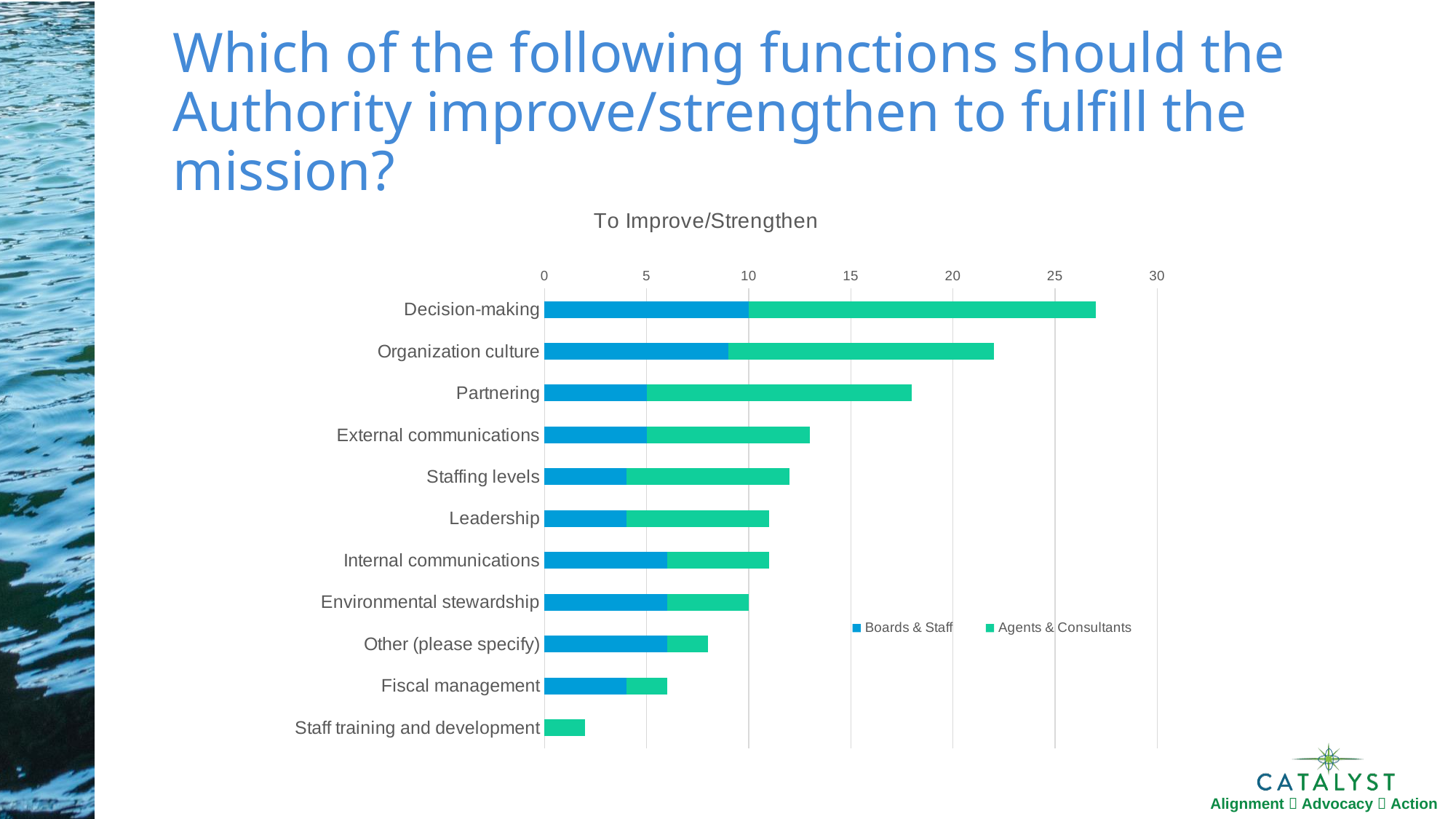
What are the two series named in the legend? Boards & Staff; Agents & Consultants What is the Boards & Staff value for Partnering? 5 Is the total value for Staff training and development greater or less than 5? less Which function has the longest total bar? Decision-making Which function has the shortest total bar? Staff training and development What is the Boards & Staff value for Decision-making? 10 Which has the larger total bar, Organization culture or Partnering? Organization culture How many series does the legend list? 2 How many functions (categories) are plotted on the chart? 11 What kind of chart is shown on the slide? Stacked bar chart What is the title of the chart? To Improve/Strengthen Is the total value for Decision-making greater or less than 25? greater